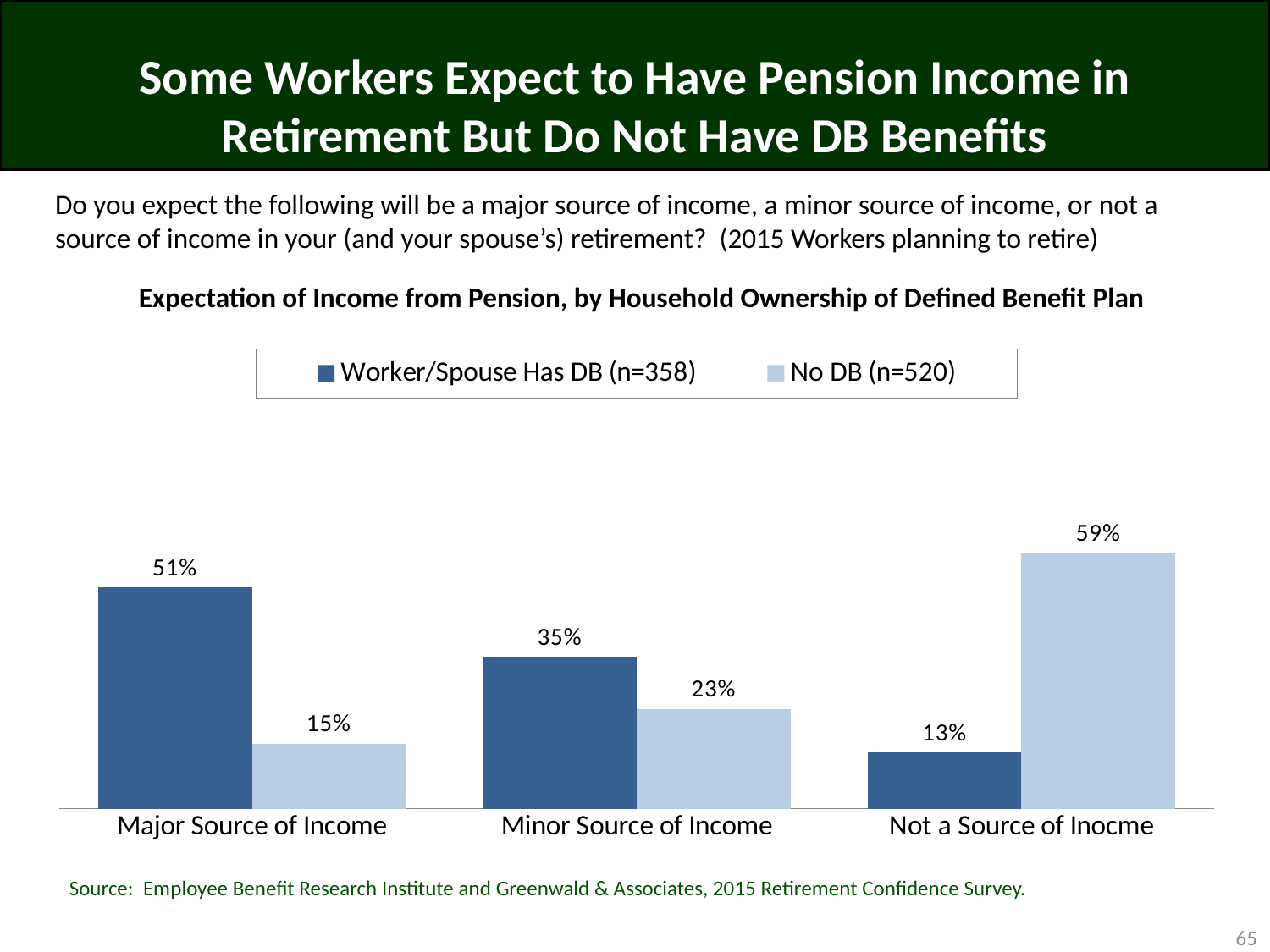
Which category has the highest value for the No DB (n=520) series? Not a Source of Inocme What kind of chart is shown on the slide? Bar chart What is the value for Worker/Spouse Has DB (n=358) in the Minor Source of Income category? 35% In the Minor Source of Income category, which series has the larger value? Worker/Spouse Has DB (n=358) What percentage of workers whose household has a DB plan expect pension to be a major source of income? 51% How many categories are shown on the x axis? 3 How many series does the legend list? 2 Which category has the lowest value for the Worker/Spouse Has DB (n=358) series? Not a Source of Inocme What is the difference between the Worker/Spouse Has DB and No DB values for Major Source of Income? 36 percentage points What is the value for No DB (n=520) in the Major Source of Income category? 15% What is the value for No DB (n=520) in the Not a Source of Inocme category? 59% What is the title of the chart? Expectation of Income from Pension, by Household Ownership of Defined Benefit Plan